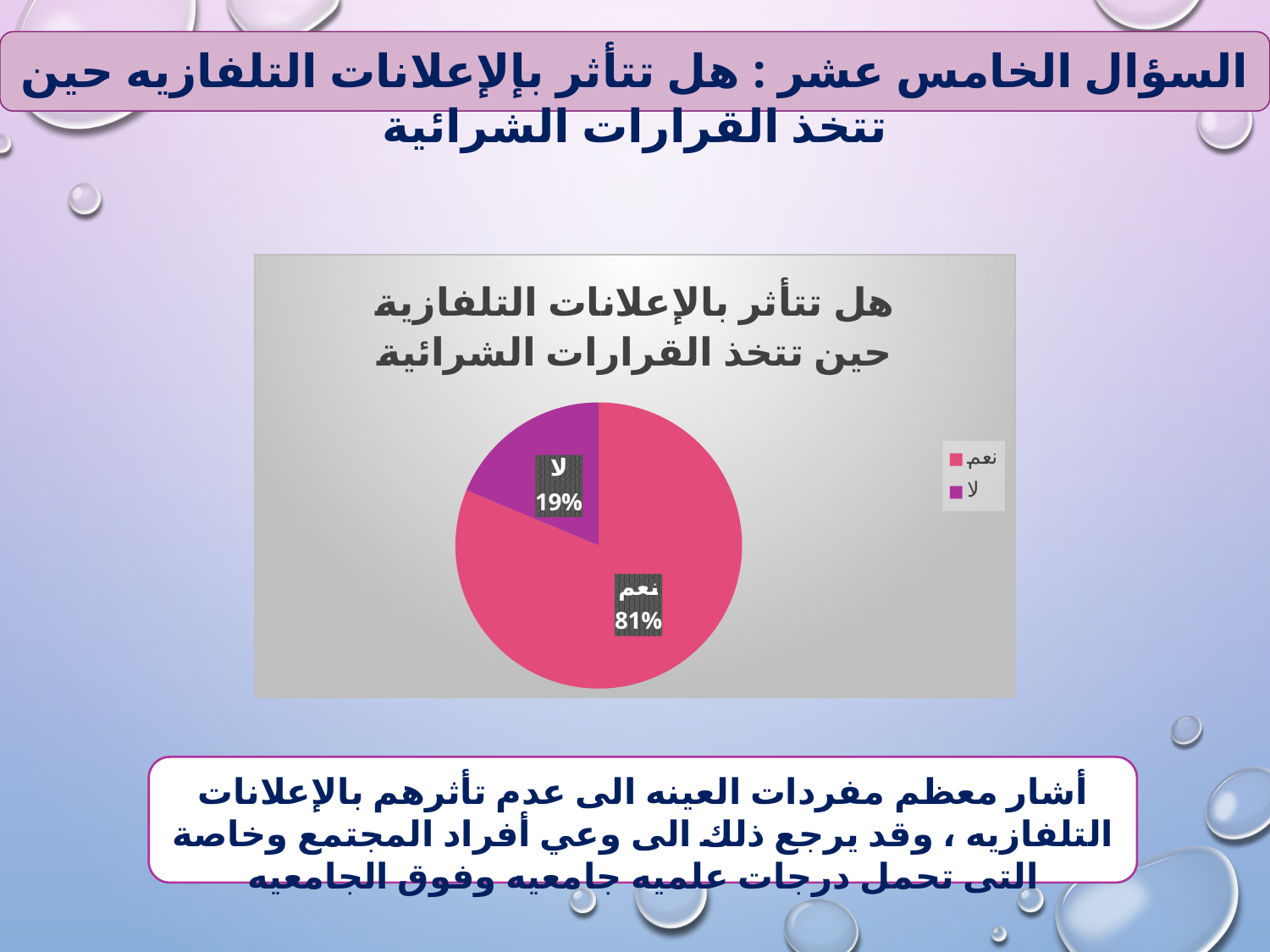
What is the title of the chart? هل تتأثر بالإعلانات التلفازية حين تتخذ القرارات الشرائية Which slice of the pie is the smallest? لا What share of the pie does the "نعم" slice represent? 81% What kind of chart is shown on the slide? pie chart What share of the pie does the "لا" slice represent? 19% What is the difference in percentage points between the "نعم" slice and the "لا" slice? 62 Which is larger, the "نعم" slice or the "لا" slice? نعم What colour is the "لا" slice in the pie chart? purple How many slices does the pie chart have? 2 Which slice of the pie is the largest? نعم How many entries does the legend list? 2